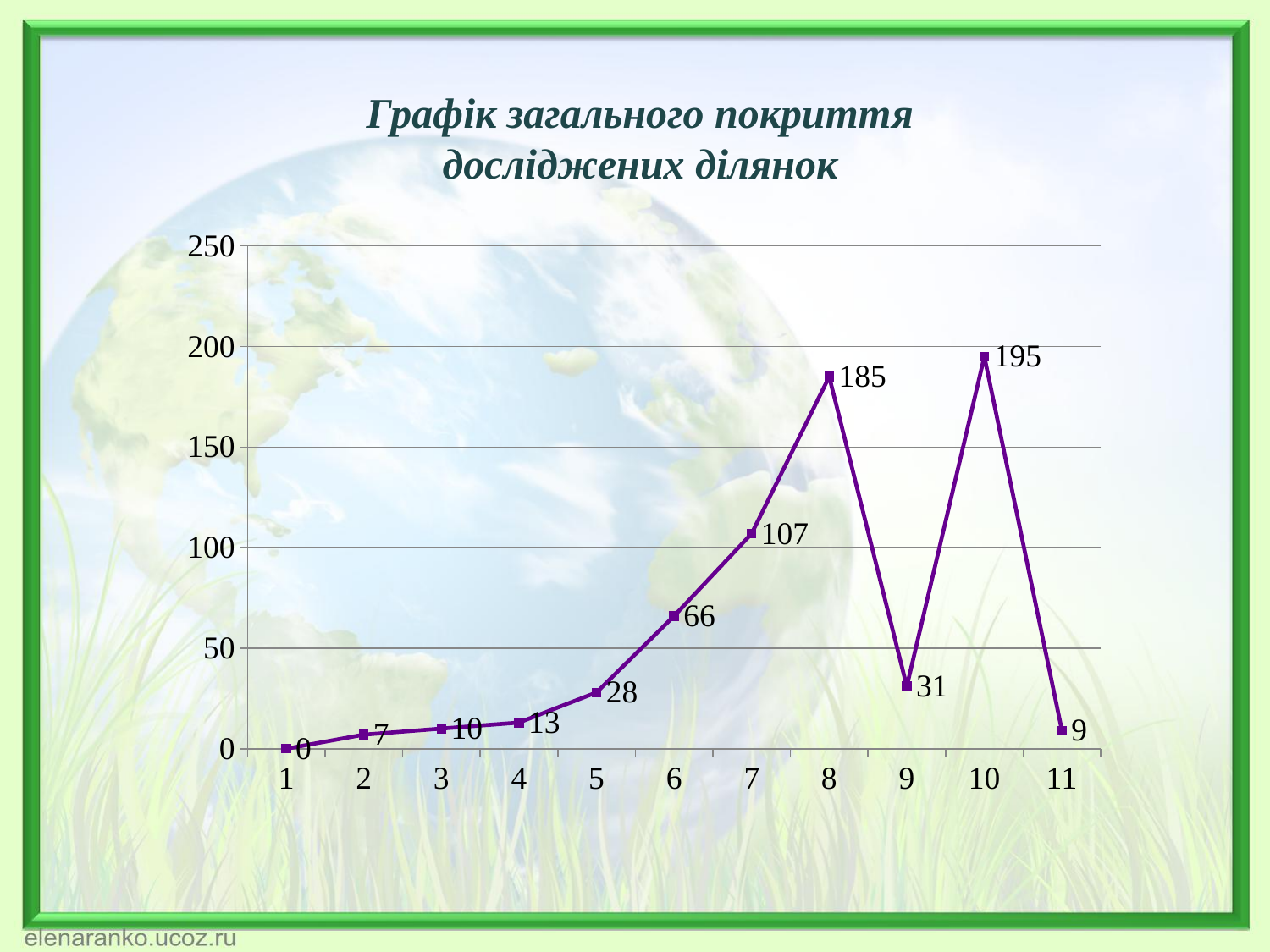
Is the value at point 7 greater or less than 100? greater Which is larger, the value at point 9 or the value at point 5? 9 What is the value at point 6? 66 What kind of chart is shown on the slide? line chart What is the difference between the values at points 7 and 6? 41 How many data points are plotted on the chart? 11 What is the difference between the values at points 10 and 8? 10 What is the value at point 8? 185 Which point on the x axis has the highest value? 10 What is the value at point 11? 9 Do the values rise or fall from point 1 to point 8? rise Which point on the x axis has the lowest value? 1